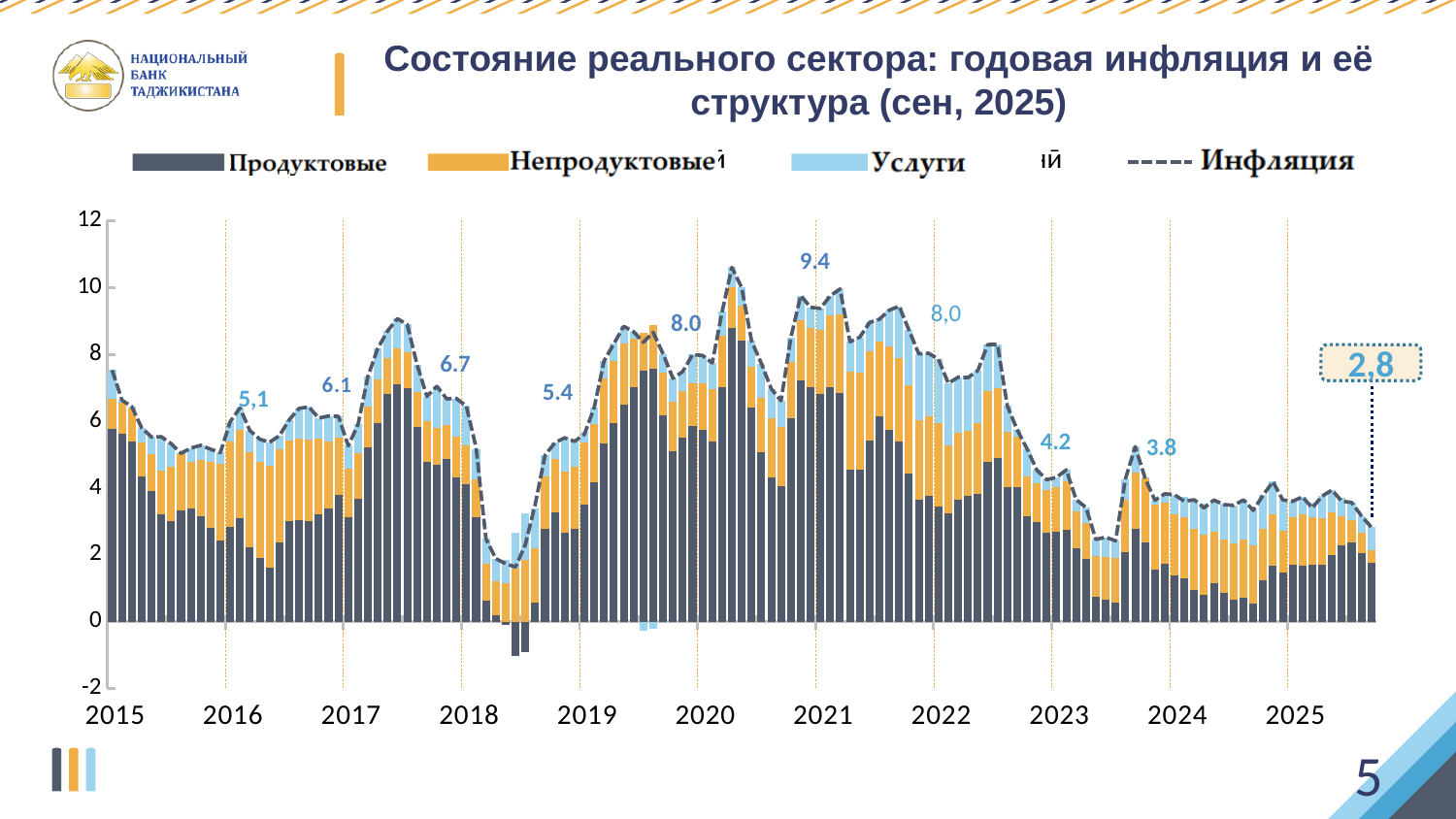
Which labelled inflation value on the chart is the highest? 9.4 Which legend entry is represented by the dashed line? Инфляция How many year labels are shown on the x axis? 11 What kind of chart is shown on the slide? bar chart with a line Which labelled inflation value on the chart is the lowest? 2,8 Does the inflation line generally rise or fall from its 2021 peak to 2025? fall What is the labelled inflation value shown near the start of 2016? 5,1 Is the inflation line at its lowest point in 2018 greater or less than 2? less What is the labelled inflation value at the peak in 2021? 9.4 What is the difference between the labelled inflation values 8.0 (2019/2020) and 5.4 (2019)? 2.6 What is the annual inflation value highlighted in the callout for September 2025? 2,8 Which is larger: the labelled inflation value 6.7 in late 2017 or 6.1 in early 2017? 6.7